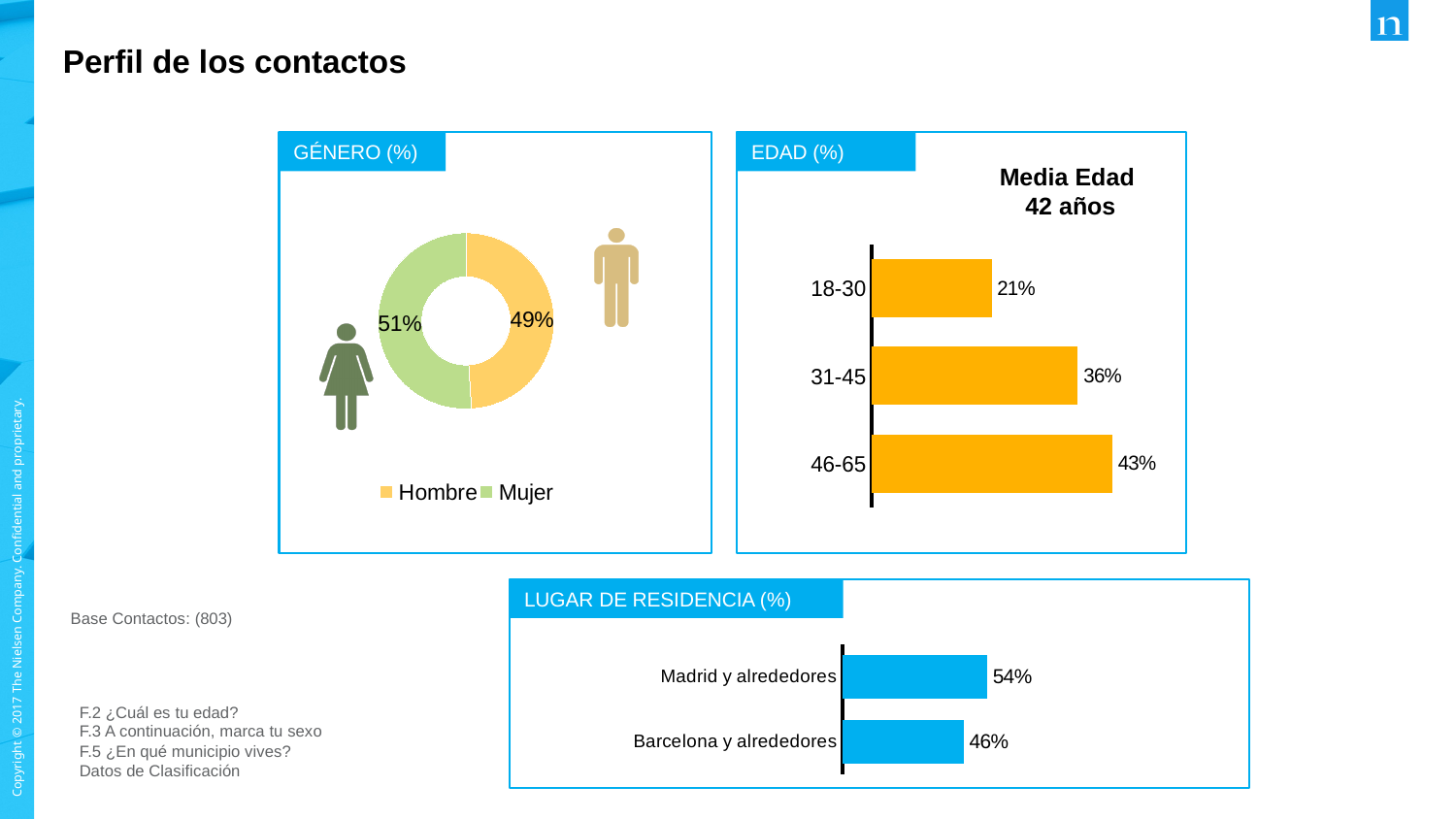
In the EDAD (%) chart, which age group has the highest value? 46-65 How many age categories are shown in the EDAD (%) chart? 3 How many series does the legend of the GÉNERO (%) chart list? 2 In the LUGAR DE RESIDENCIA (%) chart, which is larger, Madrid y alrededores or Barcelona y alrededores? Madrid y alrededores In the GÉNERO (%) chart, what percentage is Hombre? 49% In the EDAD (%) chart, what is the difference between the 46-65 and 18-30 values? 22% What kind of chart is the LUGAR DE RESIDENCIA (%) chart? Bar chart In the EDAD (%) chart, what is the value for the 31-45 age group? 36% What kind of chart is the GÉNERO (%) chart? Doughnut chart In the EDAD (%) chart, which age group has the lowest value? 18-30 In the LUGAR DE RESIDENCIA (%) chart, what is the value for Barcelona y alrededores? 46% In the GÉNERO (%) chart, what percentage is Mujer? 51%